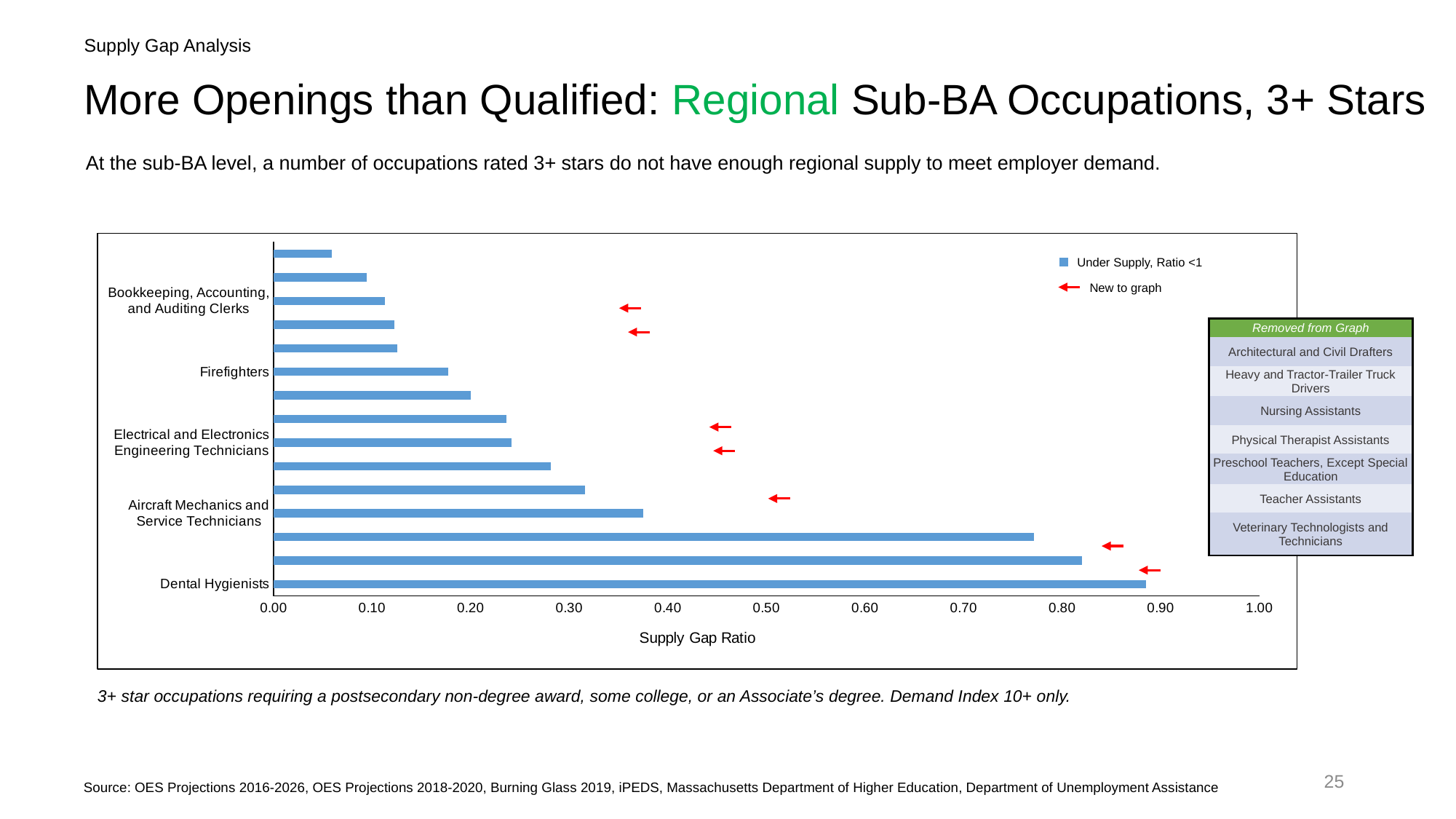
Is the Supply Gap Ratio for Dental Hygienists greater or less than 0.80? greater What does the blue square in the chart legend represent? Under Supply, Ratio <1 Is the Supply Gap Ratio for Firefighters greater or less than 0.20? less Is the Supply Gap Ratio for Electrical and Electronics Engineering Technicians greater or less than 0.20? greater What kind of chart is shown on the slide? Bar chart What is the title of the horizontal axis of the chart? Supply Gap Ratio Which has a larger Supply Gap Ratio, Aircraft Mechanics and Service Technicians or Bookkeeping, Accounting, and Auditing Clerks? Aircraft Mechanics and Service Technicians Which has a larger Supply Gap Ratio, Dental Hygienists or Firefighters? Dental Hygienists Which labeled occupation has the highest Supply Gap Ratio in the chart? Dental Hygienists How many bars are plotted in the chart? 15